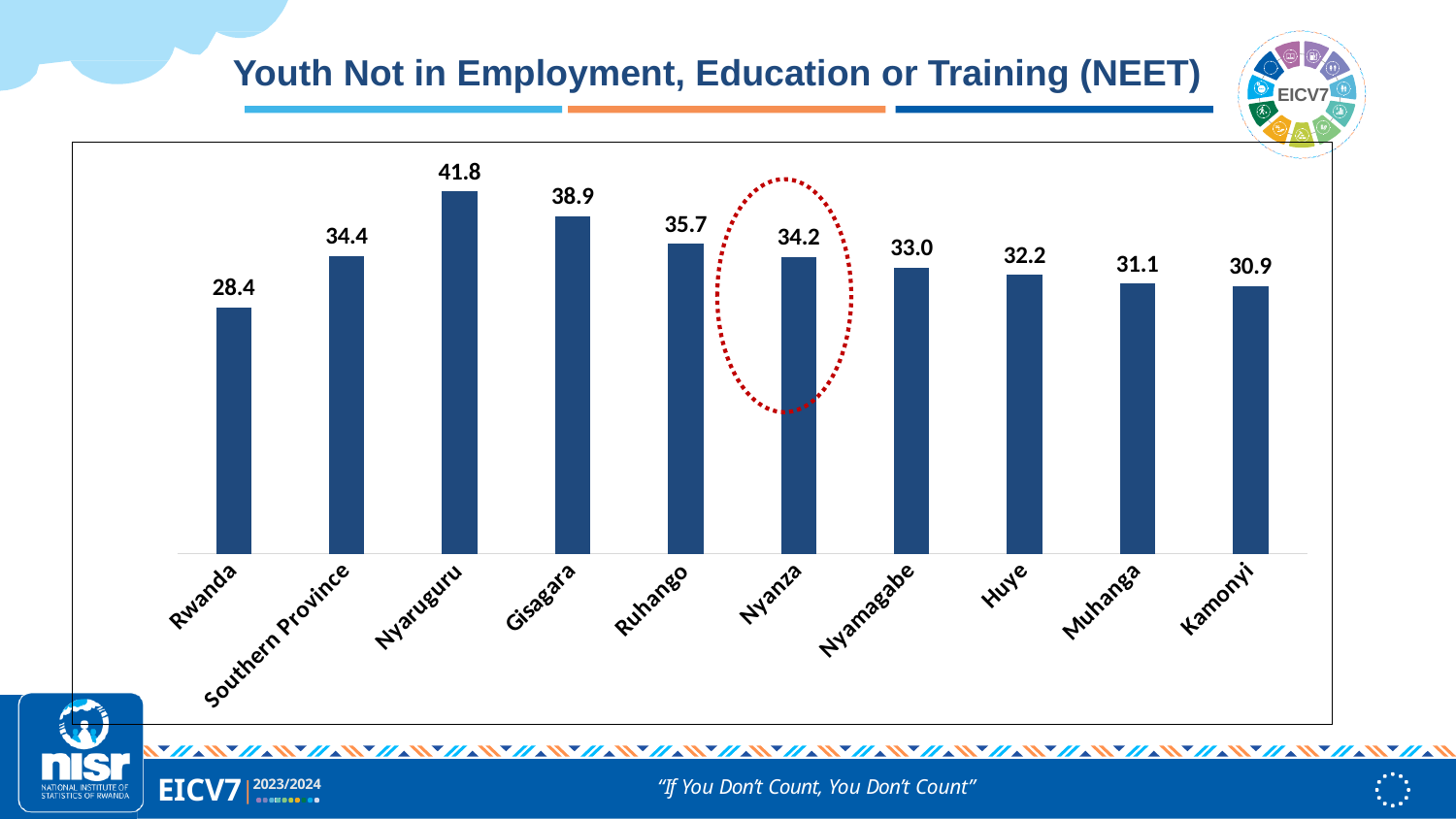
What is the NEET value for Southern Province? 34.4 What is the NEET value for Nyanza? 34.2 What kind of chart is shown on the slide? Bar chart What is the NEET value for Nyaruguru? 41.8 What is the difference between the NEET values for Nyaruguru and Rwanda? 13.4 What is the difference between the NEET values for Gisagara and Kamonyi? 8.0 How many categories are shown on the chart? 10 Which category has the lowest NEET value? Rwanda Which category's bar is circled with a red dotted outline? Nyanza Which has a higher NEET value, Ruhango or Huye? Ruhango Which category has the highest NEET value? Nyaruguru What is the NEET value for Rwanda? 28.4